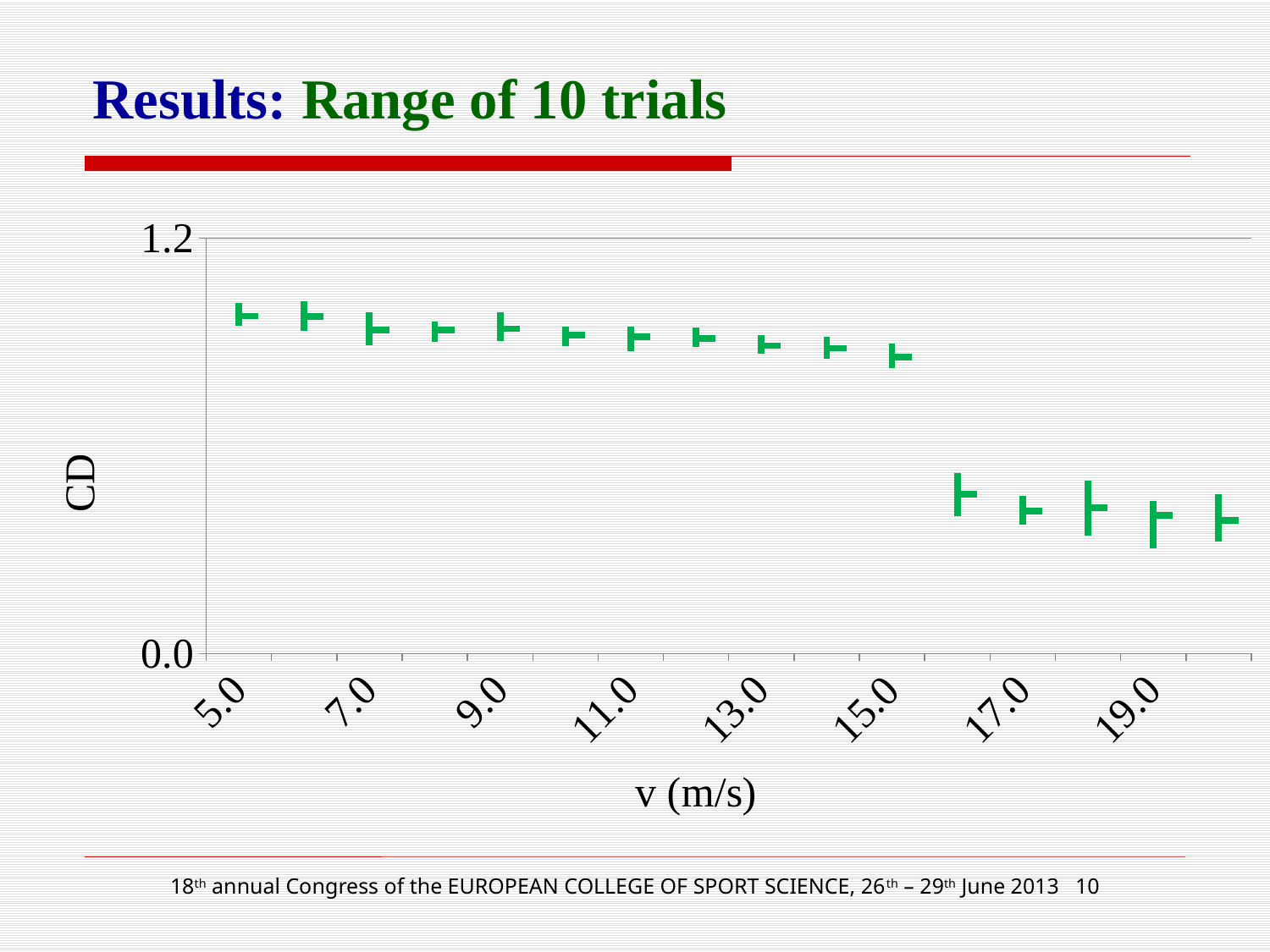
What is the lowest value shown on the y axis of the chart? 0.0 Is the CD value of the leftmost point greater or less than 1.2? less Is the CD value of the rightmost point greater or less than 0.0? greater What is the highest value shown on the y axis of the chart? 1.2 What is the last value labelled on the x axis of the chart? 19.0 What is the label on the y axis of the chart? CD What is the label on the x axis of the chart? v (m/s) Which has the larger CD value: the leftmost point or the rightmost point on the chart? the leftmost point Do the CD values generally rise or fall as v (m/s) increases along the x axis? fall What is the first value labelled on the x axis of the chart? 5.0 How many data points (range markers) are plotted on the chart? 16